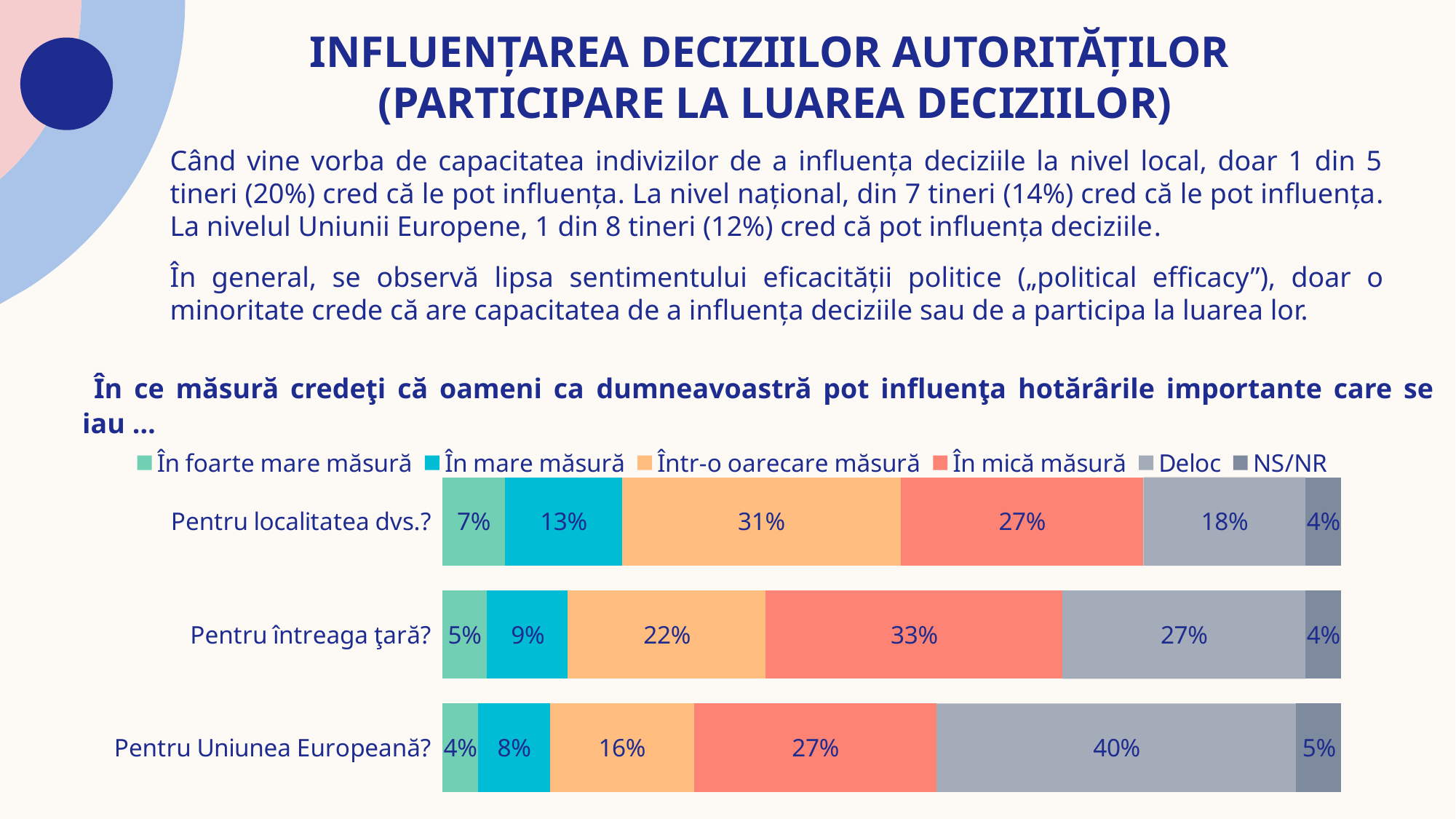
What is the value for "În foarte mare măsură" in the "Pentru Uniunea Europeană?" bar? 4% What is the difference between the "Deloc" values for "Pentru Uniunea Europeană?" and "Pentru localitatea dvs.?"? 22% How many series does the legend list? 6 What is the value for "Într-o oarecare măsură" in the "Pentru localitatea dvs.?" bar? 31% How many categories (bars) does the chart show? 3 What is the total of the "Pentru întreaga ţară?" stacked bar? 100% Which is larger: "Într-o oarecare măsură" for "Pentru localitatea dvs.?" or for "Pentru întreaga ţară?"? Pentru localitatea dvs.? What kind of chart is shown on the slide? Stacked bar chart What percentage of respondents answered "Deloc" for "Pentru Uniunea Europeană?"? 40% What is the value for "În mică măsură" in the "Pentru întreaga ţară?" bar? 33% Which category has the lowest value for "În mare măsură"? Pentru Uniunea Europeană? Which category has the highest value for "Deloc"? Pentru Uniunea Europeană?